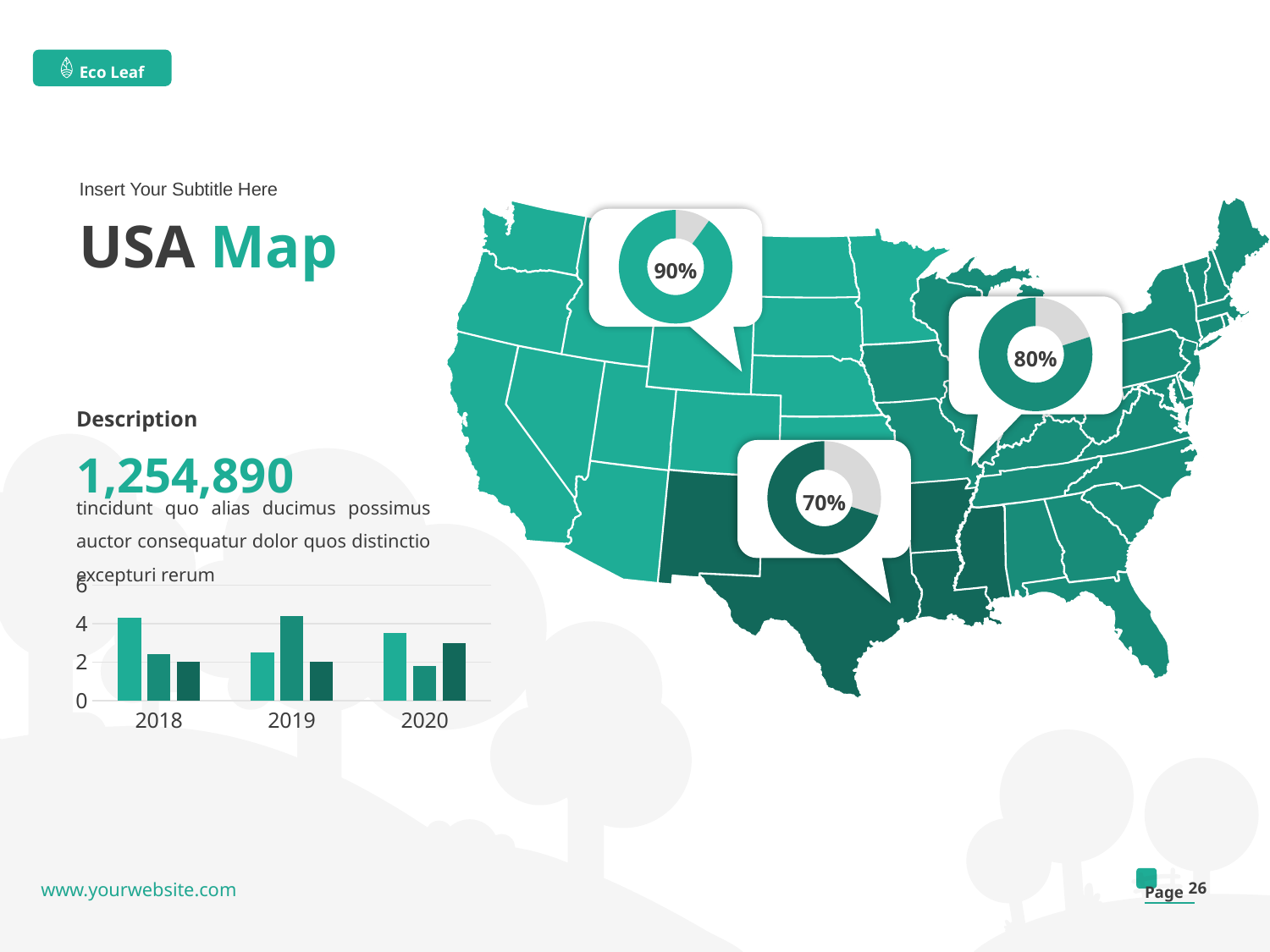
In the bar chart at the bottom left, how many bars are plotted for each year? 3 What percentage is shown in the donut chart callout over the eastern/Midwest part of the USA map? 80% In the bar chart at the bottom left, which bar is taller for 2020: the first (leftmost) bar or the middle bar? the first (leftmost) bar What percentage is shown in the donut chart callout over the northwestern part of the USA map? 90% In the bar chart at the bottom left, how many year categories are shown on the x axis? 3 In the bar chart at the bottom left, is the value of the middle bar for 2019 greater or less than 4? greater In the bar chart at the bottom left, what is the highest value shown on the y axis? 6 What percentage is shown in the donut chart callout over the southern part of the USA map? 70% Among the three donut chart callouts on the USA map, which shows the lowest percentage? 70% In the bar chart at the bottom left, is the value of the first (leftmost) bar for 2018 greater or less than 4? greater What kind of chart is shown at the bottom left of the slide, below the description text? bar chart